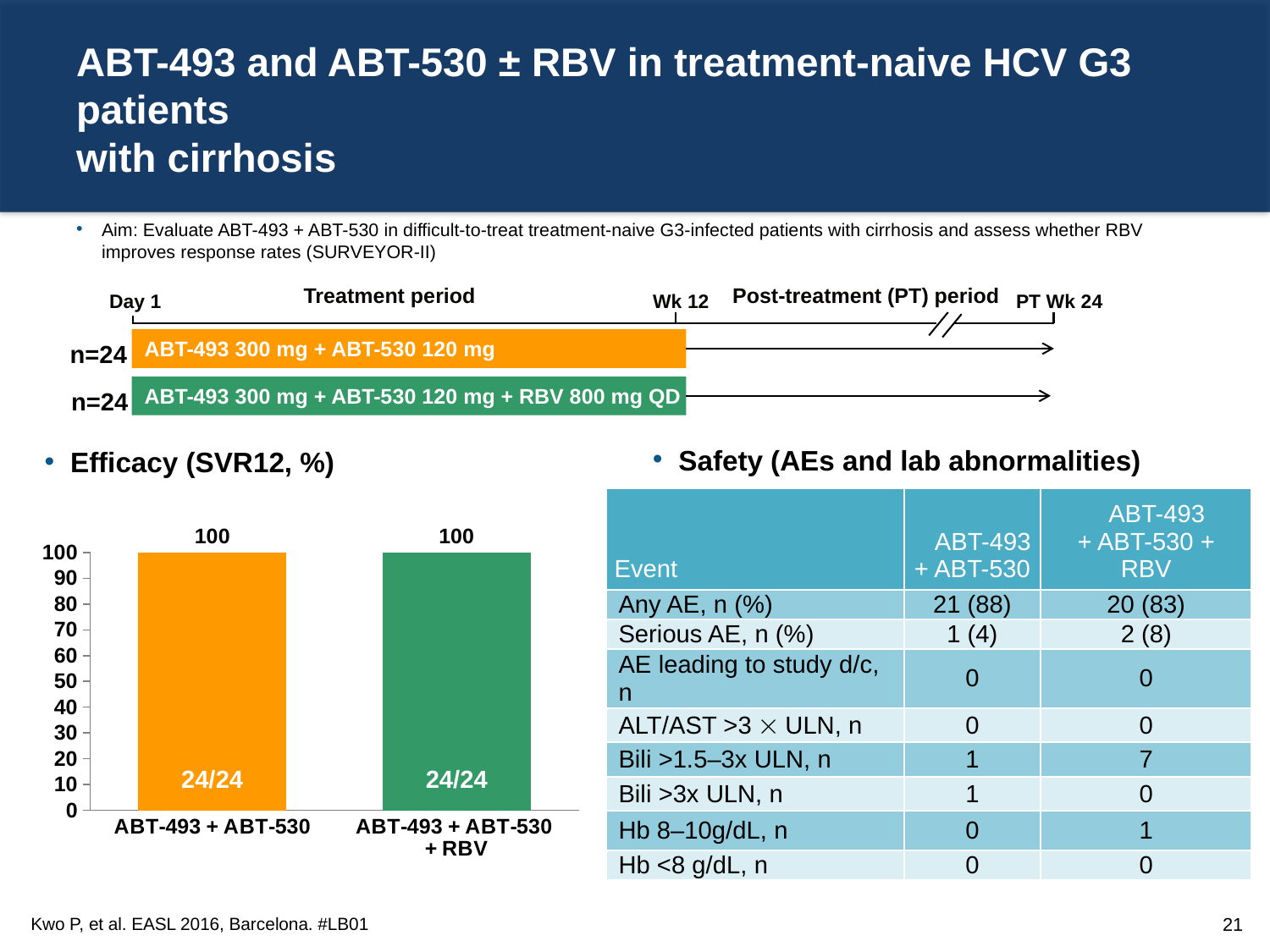
What is the SVR12 value for ABT-493 + ABT-530 + RBV in the Efficacy chart? 100 Is the SVR12 value for ABT-493 + ABT-530 + RBV greater or less than 50? greater What is the difference in SVR12 between the ABT-493 + ABT-530 + RBV bar and the ABT-493 + ABT-530 bar? 0 What is the maximum value shown on the y-axis of the Efficacy chart? 100 How many bars are shown in the Efficacy (SVR12, %) chart? 2 Is the SVR12 value for ABT-493 + ABT-530 greater or less than 90? greater What fraction of patients is printed inside the ABT-493 + ABT-530 bar? 24/24 Do the SVR12 values rise, fall, or stay the same from the ABT-493 + ABT-530 bar to the ABT-493 + ABT-530 + RBV bar? Stay the same What is the SVR12 value for ABT-493 + ABT-530 in the Efficacy chart? 100 What fraction of patients is printed inside the ABT-493 + ABT-530 + RBV bar? 24/24 What kind of chart is used to show the Efficacy (SVR12, %) data? Bar chart What colour is the ABT-493 + ABT-530 + RBV bar in the Efficacy chart? Green